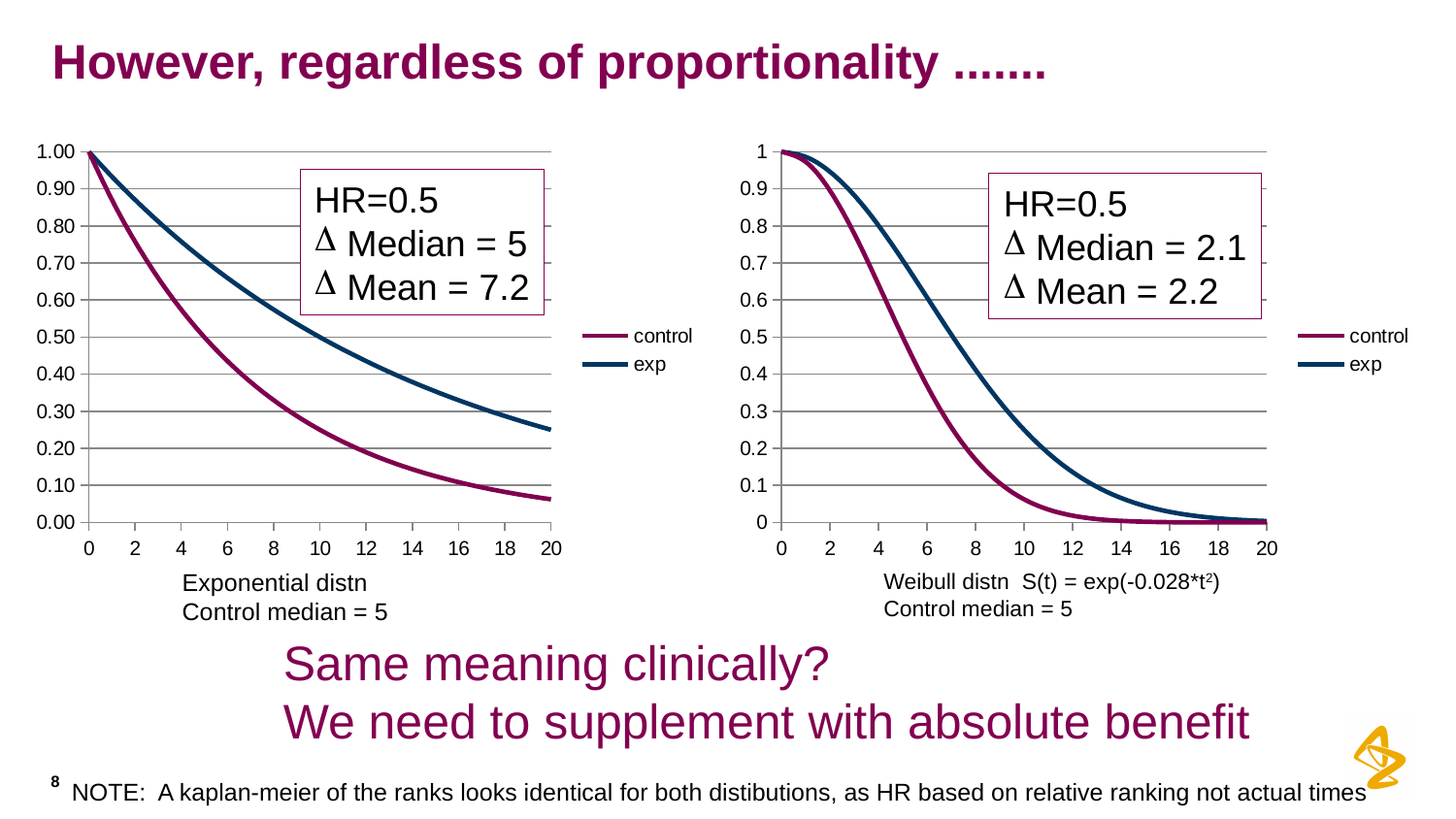
How many series does the legend of the right chart (Weibull distn) list? 2 What Δ Median value is shown in the annotation box on the right chart (Weibull distn)? 2.1 In the right chart (Weibull distn), which series is higher at x = 6, control or exp? exp In the left chart (Exponential distn), do the values of the control series rise or fall as x increases from 0 to 20? fall In the right chart (Weibull distn), what is the value of the exp series at x = 0? 1 In the left chart (Exponential distn), what is the value of the control series at x = 0? 1.00 In the left chart (Exponential distn), is the value of the control series at x = 20 greater or less than 0.10? less In the right chart (Weibull distn), do the values of the exp series rise or fall along the x axis? fall In the left chart (Exponential distn), which series is higher at x = 10, control or exp? exp In the right chart (Weibull distn), is the value of the exp series at x = 8 greater or less than 0.3? greater How many series does the legend of the left chart (Exponential distn) list? 2 What kind of chart is the left chart (Exponential distn)? line chart